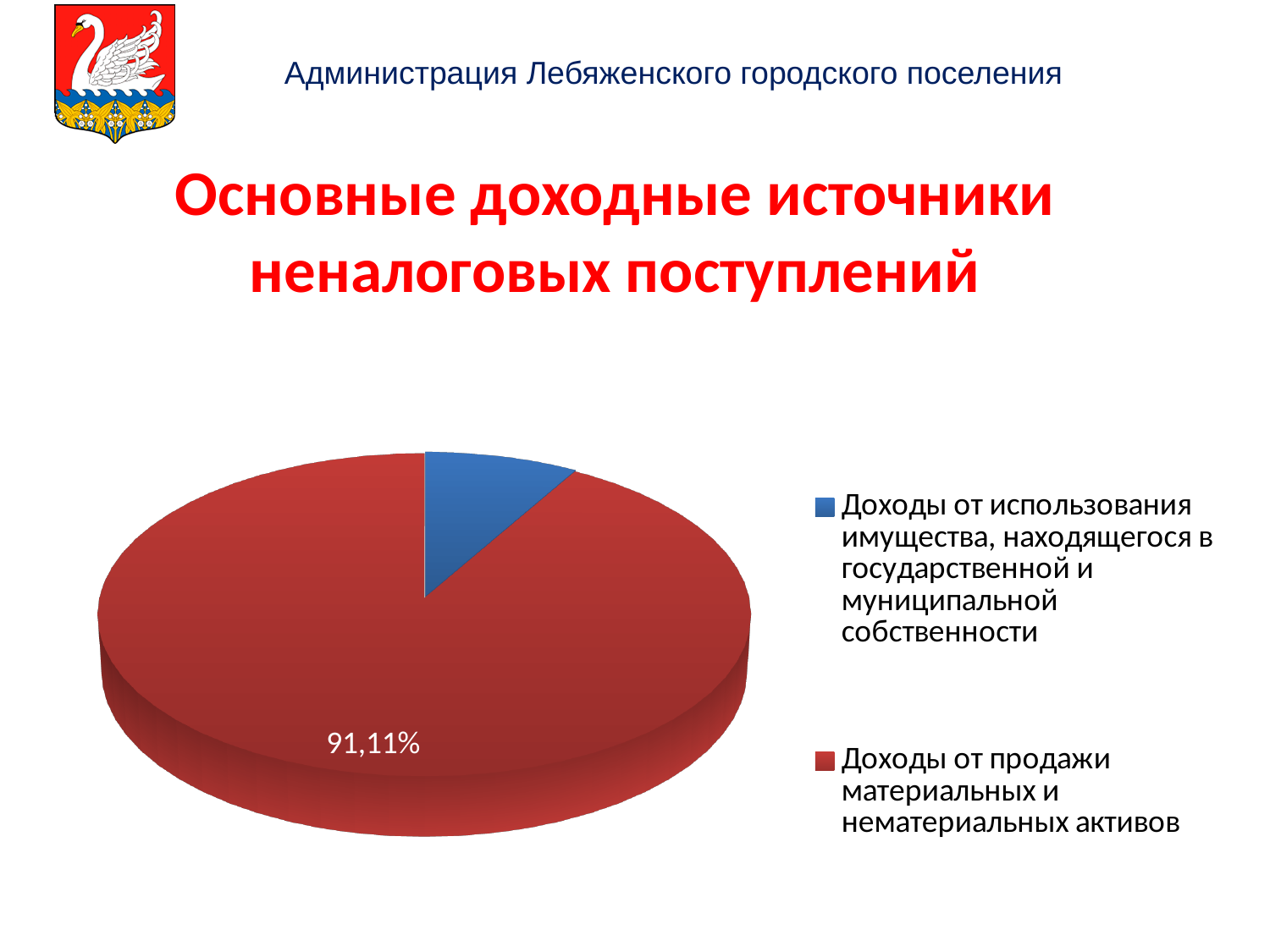
What is the title of the chart on the slide? Основные доходные источники неналоговых поступлений What kind of chart is shown on the slide? pie chart What colour is the slice for "Доходы от продажи материальных и нематериальных активов"? red Is the share for "Доходы от использования имущества, находящегося в государственной и муниципальной собственности" greater or less than 50%? less Which category has the smallest slice of the pie? Доходы от использования имущества, находящегося в государственной и муниципальной собственности What share of the pie is labelled for "Доходы от продажи материальных и нематериальных активов"? 91,11% How many slices does the pie chart have? 2 What value is printed on the red slice of the pie chart? 91,11% Which is larger: the slice for "Доходы от использования имущества, находящегося в государственной и муниципальной собственности" or the slice for "Доходы от продажи материальных и нематериальных активов"? Доходы от продажи материальных и нематериальных активов Which category has the largest slice of the pie? Доходы от продажи материальных и нематериальных активов How many entries does the legend list? 2